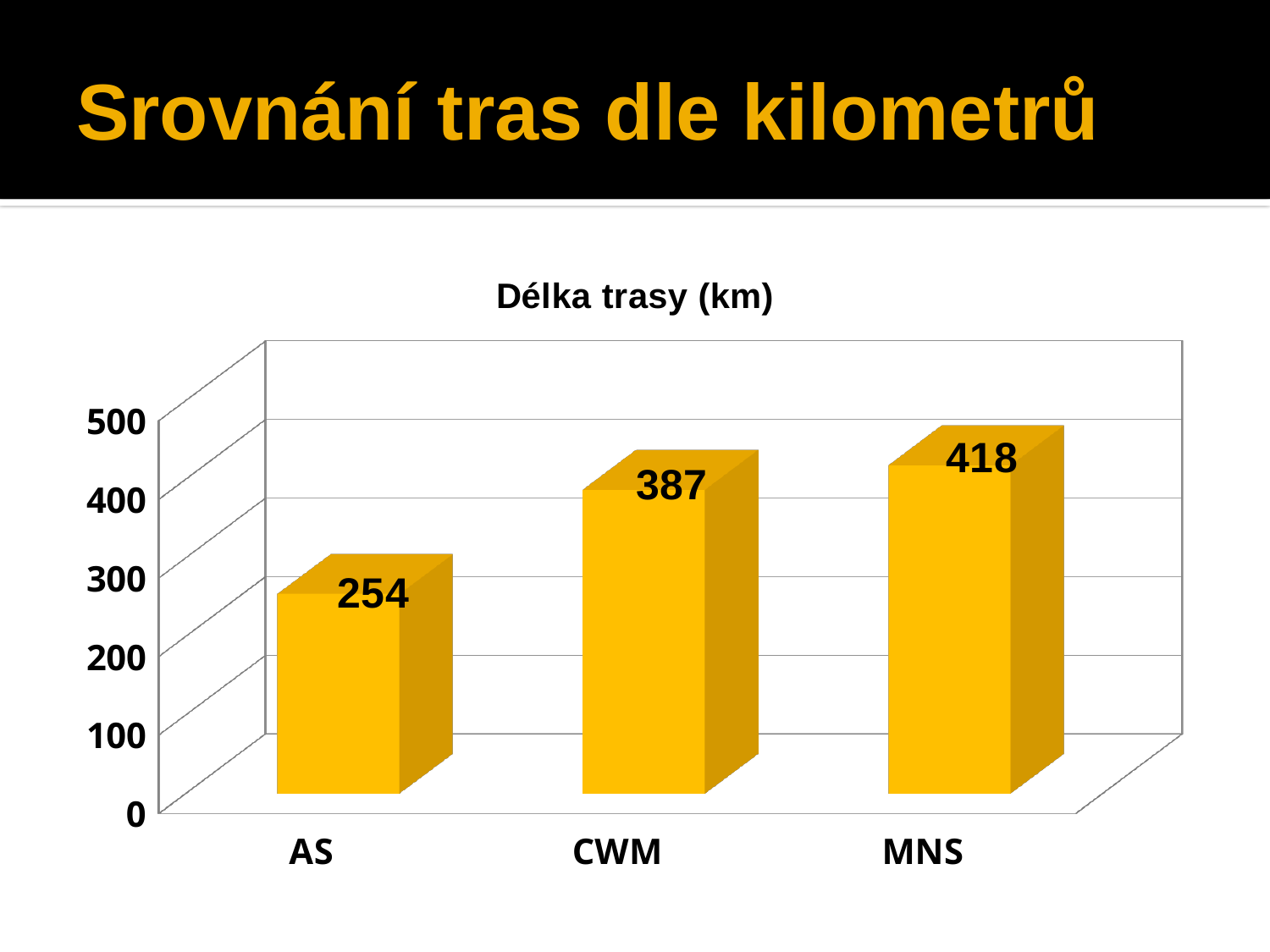
What is the title of the chart? Délka trasy (km) How many categories are shown on the x axis? 3 What is the difference between the values for CWM and AS? 133 What kind of chart is shown on the slide? bar chart Which is larger, the value for CWM or the value for MNS? MNS What is the difference between the values for MNS and AS? 164 Is the value for AS greater or less than 300? less What is the value for MNS? 418 Which category has the lowest value? AS What is the value for AS? 254 Which category has the highest value? MNS What is the value for CWM? 387